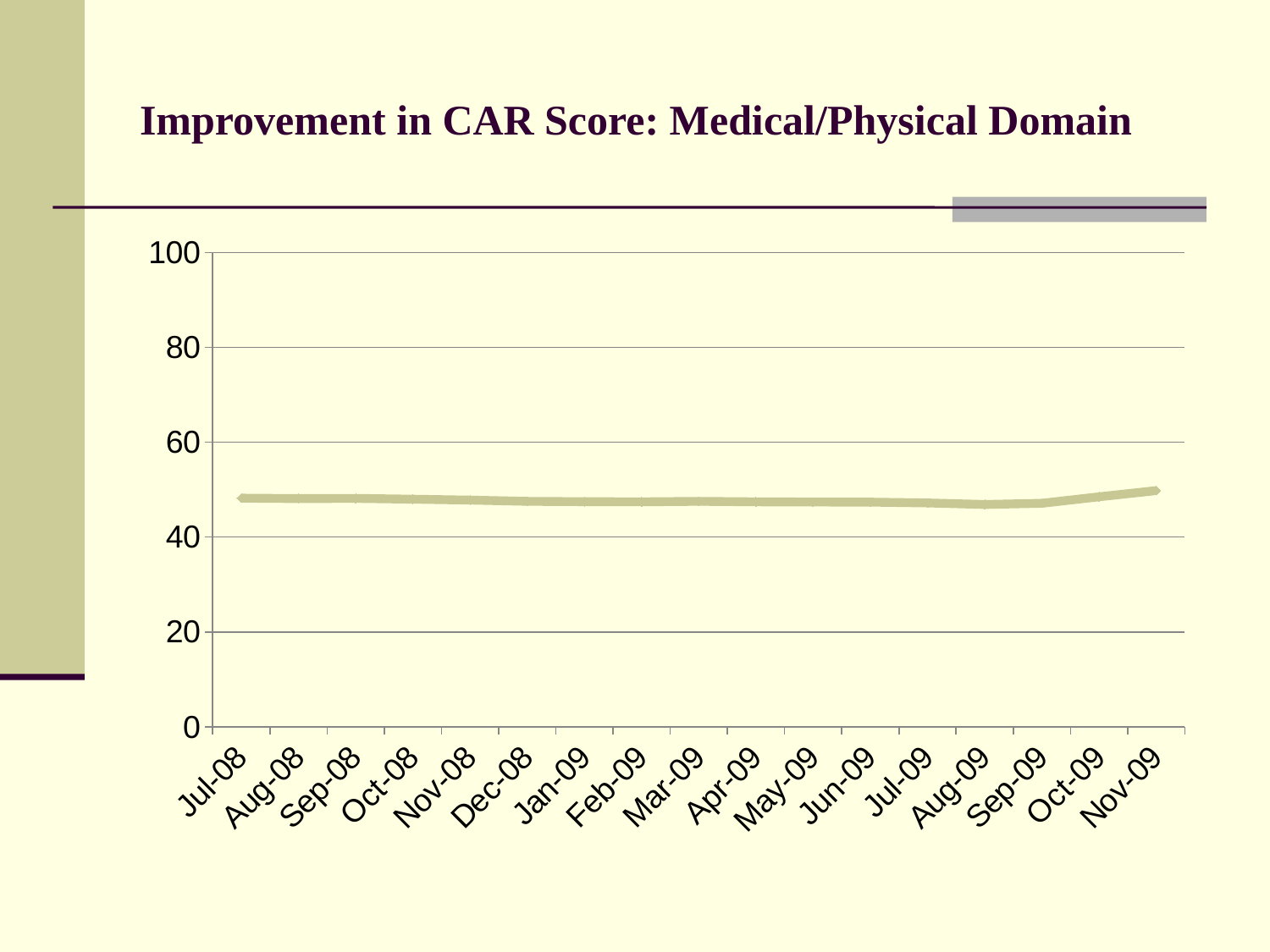
What kind of chart is shown on the slide? line chart Is the value for Jul-08 greater or less than 40? greater What is the highest value shown on the y axis? 100 How many lines are plotted on the chart? 1 Which is larger, the value for Nov-09 or the value for Aug-09? Nov-09 Is the value for Jul-08 greater or less than 60? less What is the first month shown on the x axis? Jul-08 Is the value for Nov-09 greater or less than 60? less Which month has the highest value on the chart? Nov-09 How many months are plotted along the x axis of the chart? 17 What is the title of the chart on the slide? Improvement in CAR Score: Medical/Physical Domain